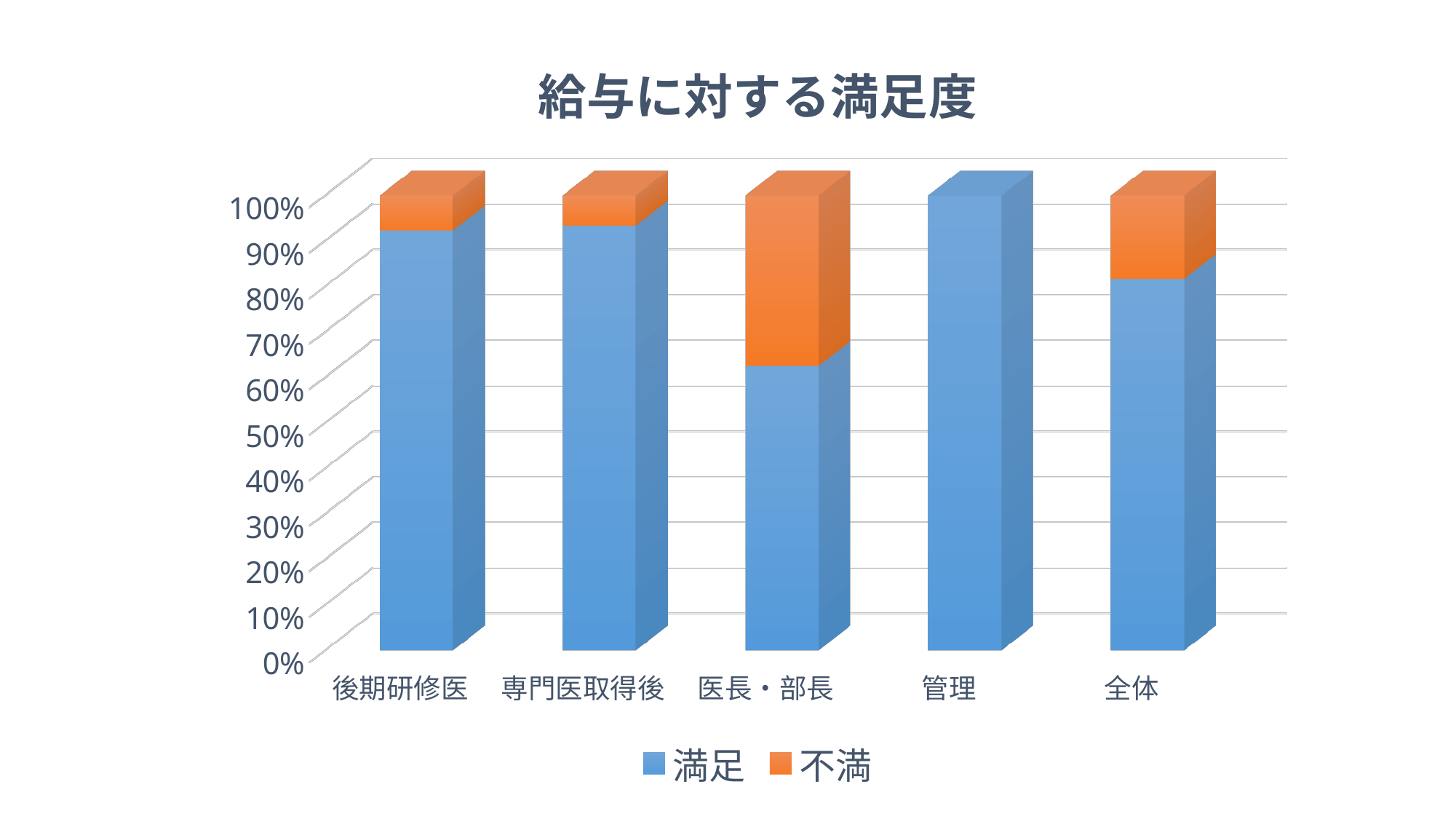
How many series does the legend list? 2 Is the 満足 value for 全体 greater or less than 70%? greater Which has a larger 満足 share, 後期研修医 or 医長・部長? 後期研修医 Is the 満足 value for 医長・部長 greater or less than 50%? greater Which colour represents 不満 in the legend? Orange Which category has the largest 不満 share? 医長・部長 Which category has the highest 満足 share? 管理 Is the 不満 value for 医長・部長 greater or less than 20%? greater What kind of chart is shown on the slide? Stacked bar chart Which category has the lowest 満足 share? 医長・部長 How many categories are shown on the x axis? 5 What is the title of the chart? 給与に対する満足度